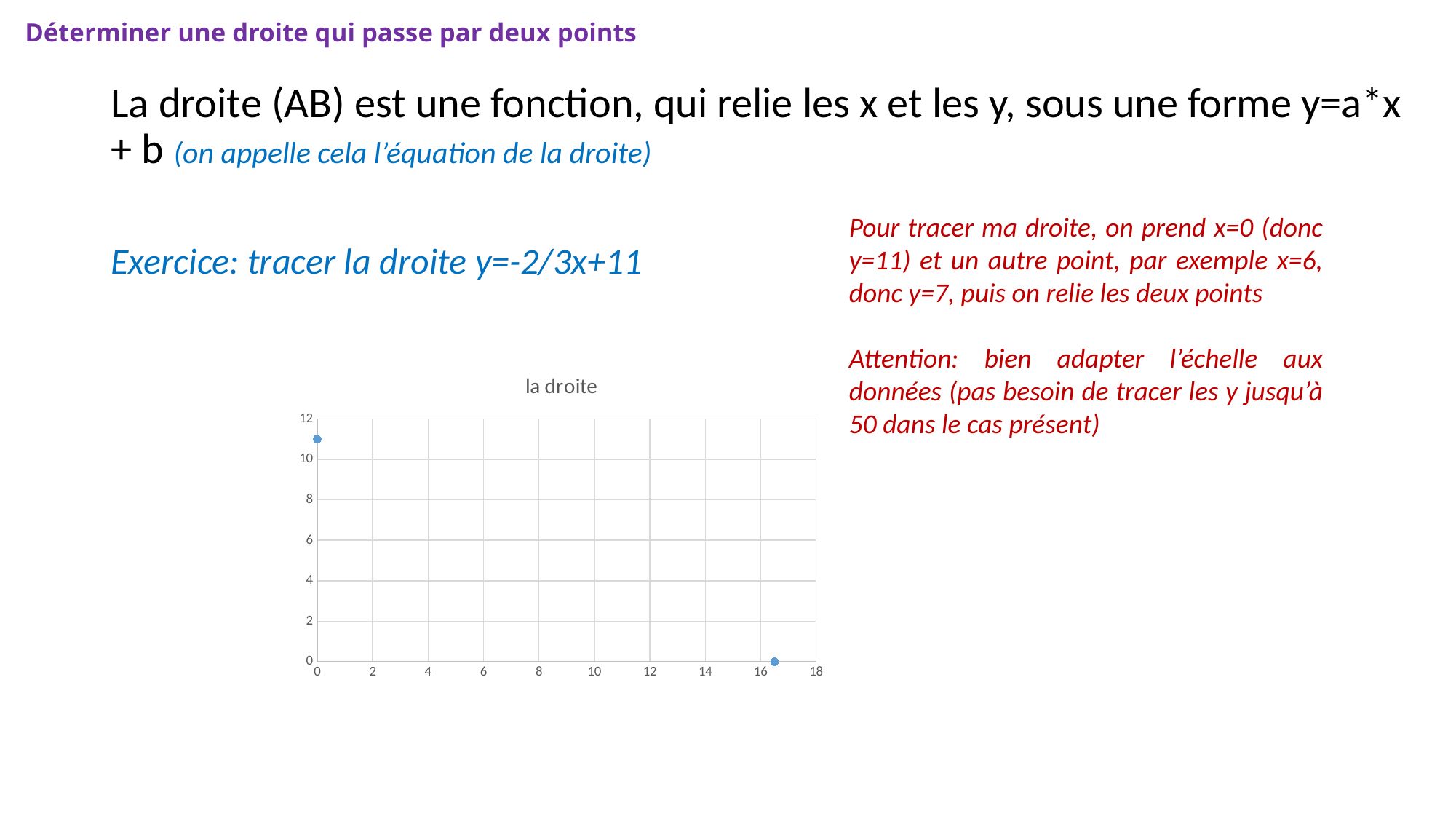
Is the x value of the point on the bottom axis greater or less than 16? greater How many data points are plotted on the chart? 2 Is the y value of the point at x=0 greater or less than 10? greater What is the y value of the point plotted on the bottom edge of the chart, near the right? 0 What kind of chart is shown on the slide? scatter chart Which point has the higher y value: the one at x=0 or the one near x=16? the one at x=0 Do the plotted values rise or fall as x increases? fall Is the y value of the point on the right side of the chart greater or less than 2? less What is the x value of the point plotted on the left edge of the chart? 0 What is the title of the chart? la droite What is the highest value shown on the y axis? 12